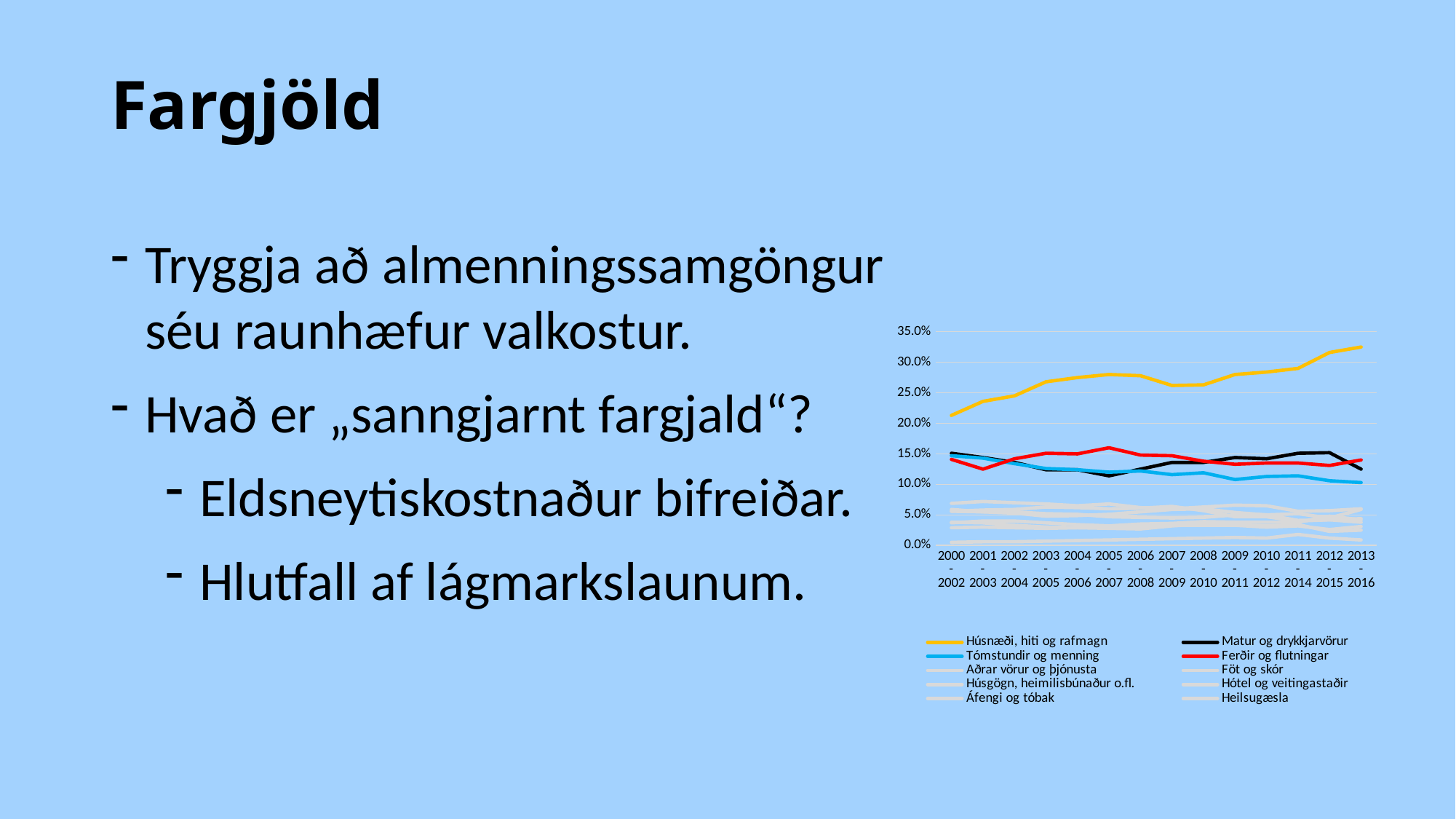
Is the value for Tómstundir og menning at 2013-2016 greater or less than 15.0%? less What is the highest value shown on the chart's y axis? 35.0% How many points are plotted along the x axis of the chart? 14 What colour is the line for Húsnæði, hiti og rafmagn? yellow How many series does the chart's legend list? 10 Is the value for Húsnæði, hiti og rafmagn at 2000-2002 greater or less than 25.0%? less At 2013-2016, which is larger: Húsnæði, hiti og rafmagn or Matur og drykkjarvörur? Húsnæði, hiti og rafmagn Does the Húsnæði, hiti og rafmagn line rise or fall from 2000-2002 to 2013-2016? rise What kind of chart is shown on the slide? line chart Does the Tómstundir og menning line rise or fall from 2000-2002 to 2013-2016? fall Is the value for Húsnæði, hiti og rafmagn at 2013-2016 greater or less than 30.0%? greater Which series has the highest values throughout the chart? Húsnæði, hiti og rafmagn